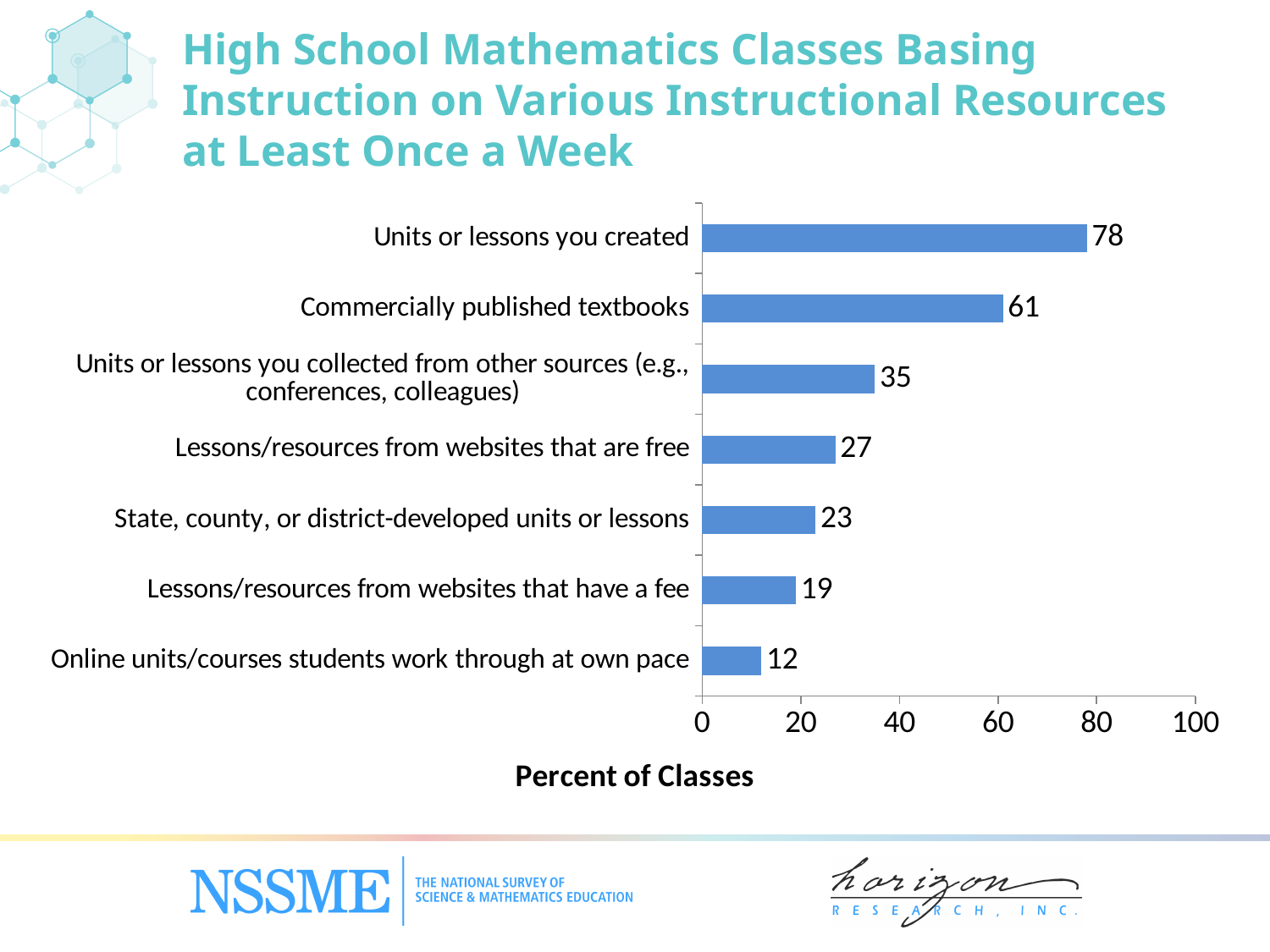
What is the label of the horizontal axis? Percent of Classes Which instructional resource has the lowest percent of classes? Online units/courses students work through at own pace Is the value for commercially published textbooks greater or less than 40? greater Which instructional resource has the highest percent of classes? Units or lessons you created What is the difference between the values for units or lessons you created and commercially published textbooks? 17 Which is larger: the value for state, county, or district-developed units or lessons, or the value for units or lessons you collected from other sources? Units or lessons you collected from other sources What is the value for commercially published textbooks? 61 What percent of classes base instruction on units or lessons you created at least once a week? 78 How many instructional resource categories are shown in the chart? 7 What is the value for lessons/resources from websites that have a fee? 19 What is the difference between the values for lessons/resources from websites that are free and lessons/resources from websites that have a fee? 8 What kind of chart is shown on the slide? Bar chart